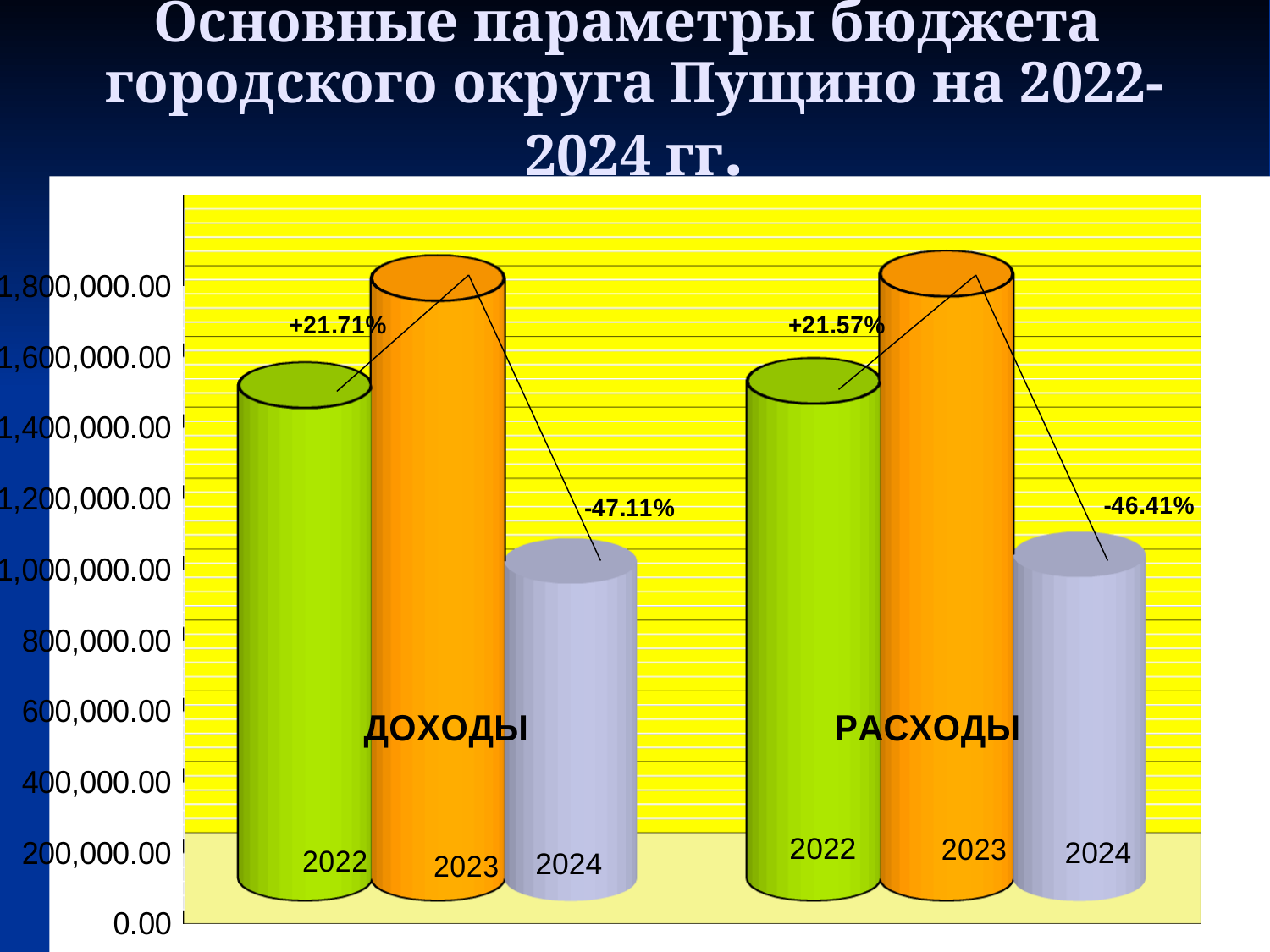
What percentage change is labelled between 2023 and 2024 for РАСХОДЫ? -46.41% What are the two groups of bars labelled on the chart? ДОХОДЫ and РАСХОДЫ What percentage change is labelled between 2023 and 2024 for ДОХОДЫ? -47.11% What percentage change is labelled between 2022 and 2023 for ДОХОДЫ? +21.71% What kind of chart is shown on the slide? bar chart Which year has the lowest bar in the РАСХОДЫ group? 2024 Which year has the highest bar in the ДОХОДЫ group? 2023 Is the value for РАСХОДЫ in 2024 greater or less than 1,200,000.00? less What percentage change is labelled between 2022 and 2023 for РАСХОДЫ? +21.57% How many bars are plotted in the chart in total? 6 In the ДОХОДЫ group, which bar is taller: 2022 or 2024? 2022